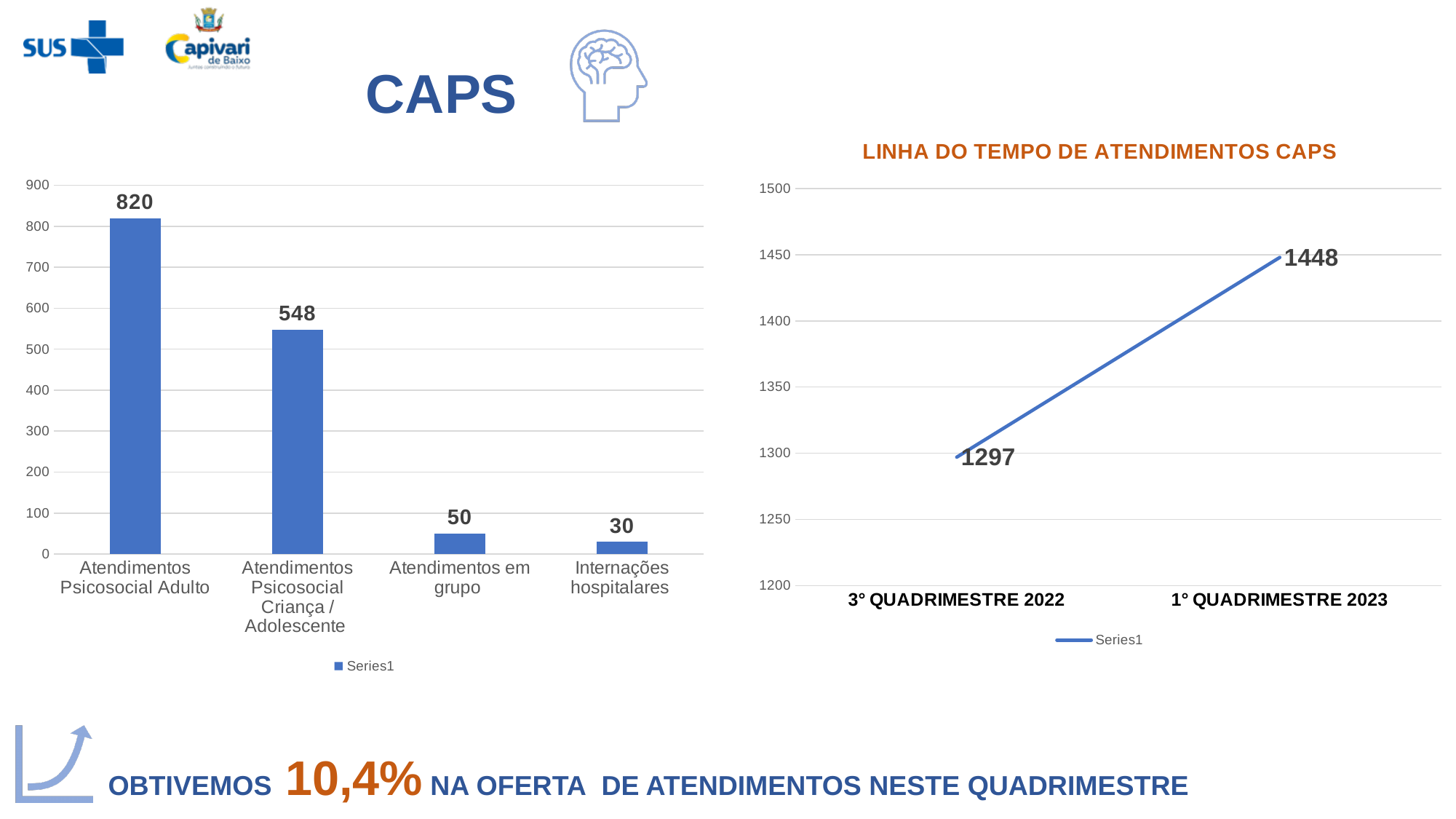
How many categories does the bar chart on the left show? 4 What kind of chart is the chart on the left? bar chart In the bar chart on the left, what is the value for Internações hospitalares? 30 In the chart titled LINHA DO TEMPO DE ATENDIMENTOS CAPS, what is the value for 1° QUADRIMESTRE 2023? 1448 In the chart titled LINHA DO TEMPO DE ATENDIMENTOS CAPS, what is the value for 3° QUADRIMESTRE 2022? 1297 In the chart titled LINHA DO TEMPO DE ATENDIMENTOS CAPS, do the values rise or fall from 3° QUADRIMESTRE 2022 to 1° QUADRIMESTRE 2023? rise In the bar chart on the left, which category has the lowest value? Internações hospitalares In the chart titled LINHA DO TEMPO DE ATENDIMENTOS CAPS, what is the difference between 1° QUADRIMESTRE 2023 and 3° QUADRIMESTRE 2022? 151 In the bar chart on the left, what is the difference between Atendimentos Psicosocial Adulto and Atendimentos Psicosocial Criança / Adolescente? 272 In the bar chart on the left, what is the value for Atendimentos Psicosocial Adulto? 820 In the bar chart on the left, which is larger: Atendimentos em grupo or Internações hospitalares? Atendimentos em grupo In the bar chart on the left, which category has the highest value? Atendimentos Psicosocial Adulto